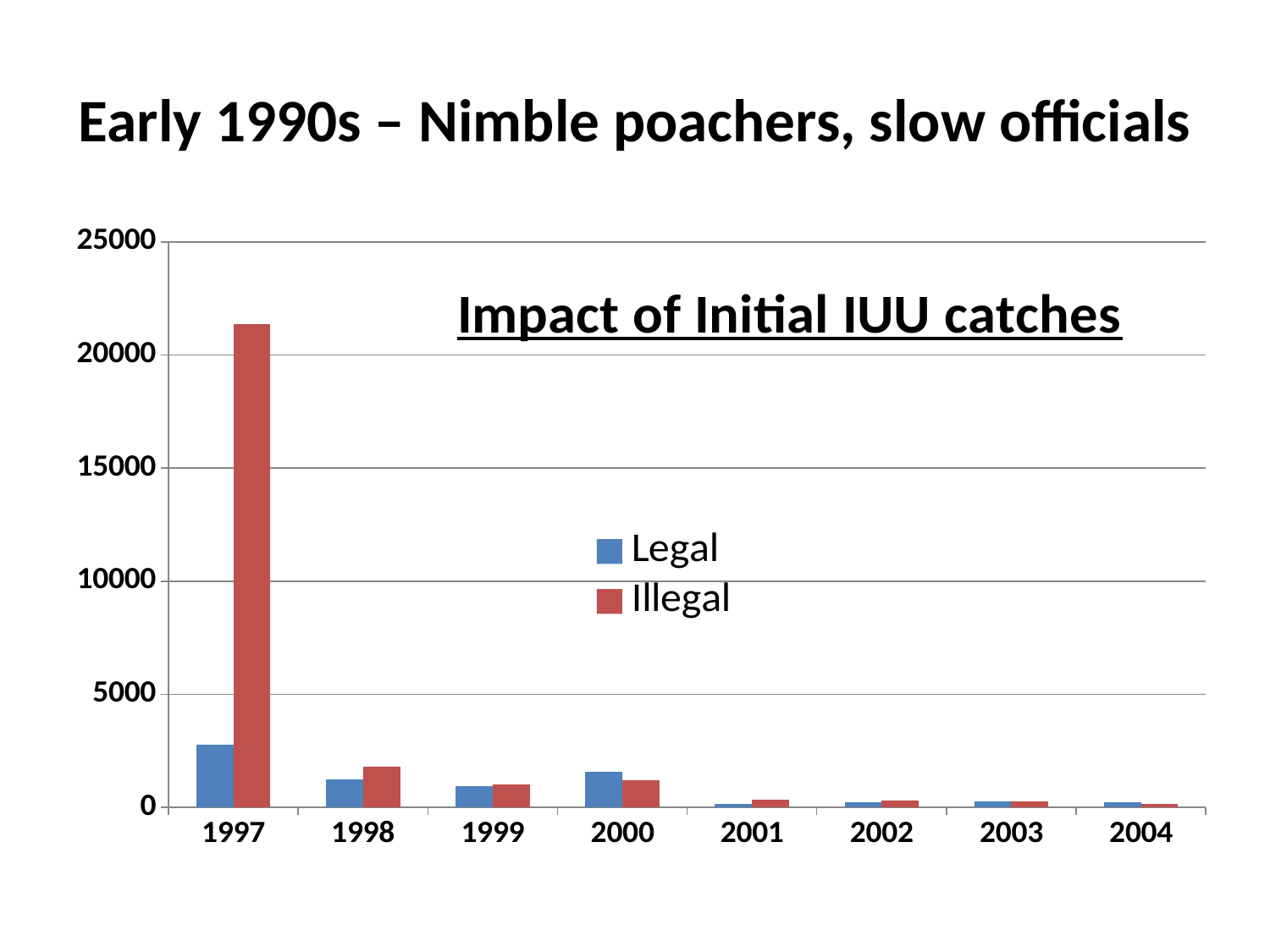
Does the Illegal value rise or fall from 1997 to 2001? fall Is the Legal value for 1997 greater or less than 5000? less In which year is the Illegal value highest? 1997 In 2000, which is larger, Legal or Illegal? Legal Is the Illegal value for 1997 greater or less than 20000? greater What is the title of the chart? Impact of Initial IUU catches What kind of chart is shown on the slide? bar chart In which year is the Legal value highest? 1997 How many series does the legend list? 2 In 1997, which is larger, Legal or Illegal? Illegal How many years are shown on the x axis? 8 In 1998, which is larger, Legal or Illegal? Illegal